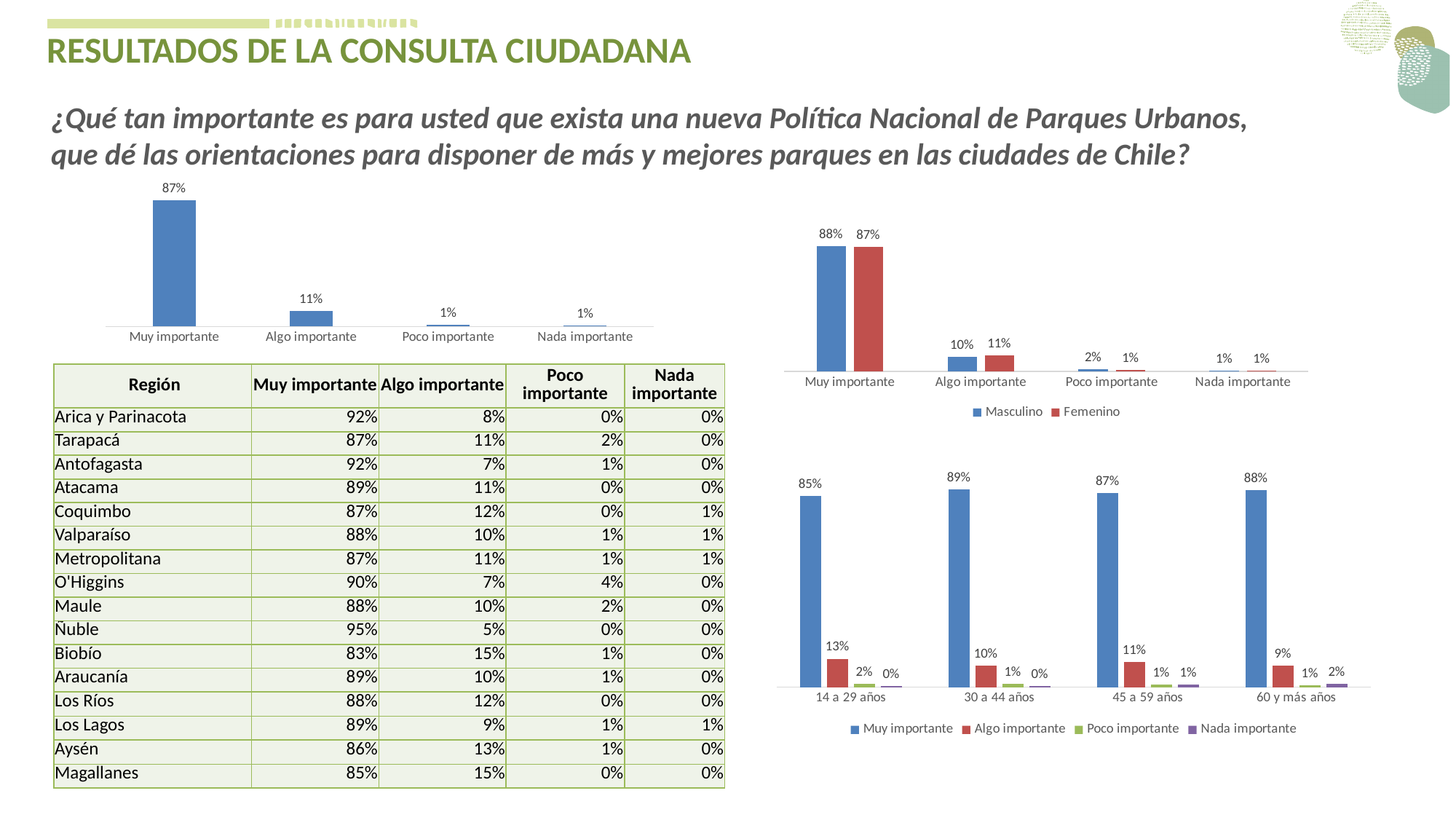
In the top-right chart, what is the Masculino value for Muy importante? 88% In the bottom-right chart, what is the Algo importante value for 14 a 29 años? 13% In the top-left chart, what is the value for Muy importante? 87% In the top-left chart, which category has the highest value? Muy importante In the bottom-right chart, how many series does the legend list? 4 In the top-right chart, how many series does the legend list? 2 In the top-right chart, what is the Femenino value for Algo importante? 11% In the bottom-right chart, which age group has the lowest Muy importante value? 14 a 29 años In the bottom-right chart, what is the Muy importante value for 30 a 44 años? 89% In the top-left chart, how many categories are shown on the x axis? 4 In the top-left chart, what is the difference between Muy importante and Algo importante? 76% In the top-right chart, which is larger for Poco importante: Masculino or Femenino? Masculino